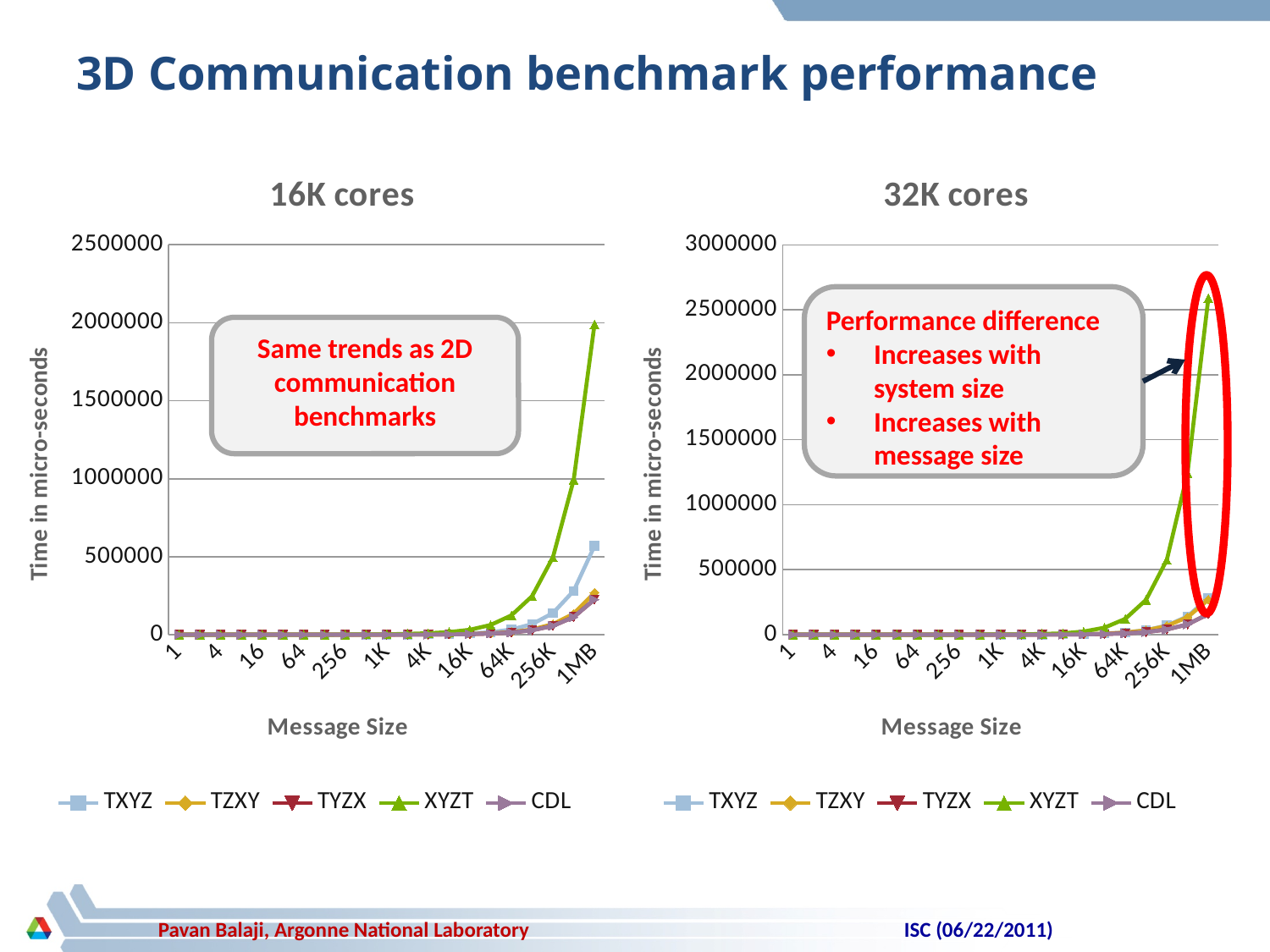
How many series does the legend of the "32K cores" chart list? 5 In the "32K cores" chart, which series has the highest value at message size 1MB? XYZT In the "32K cores" chart, is the value for TXYZ at 1MB greater or less than 500000? less In the "16K cores" chart, is the value for XYZT at 1MB greater or less than 1500000? greater What is the y-axis label of the "32K cores" chart? Time in micro-seconds In the "16K cores" chart, does the XYZT series rise or fall as message size increases along the x axis? rise In the "16K cores" chart, which series has the highest value at message size 1MB? XYZT In the "16K cores" chart, is the value for TXYZ at 1MB greater or less than 1000000? less What kind of chart is the "16K cores" chart? line chart What is the x-axis label of the "16K cores" chart? Message Size In the "32K cores" chart, which is larger at 1MB: XYZT or CDL? XYZT